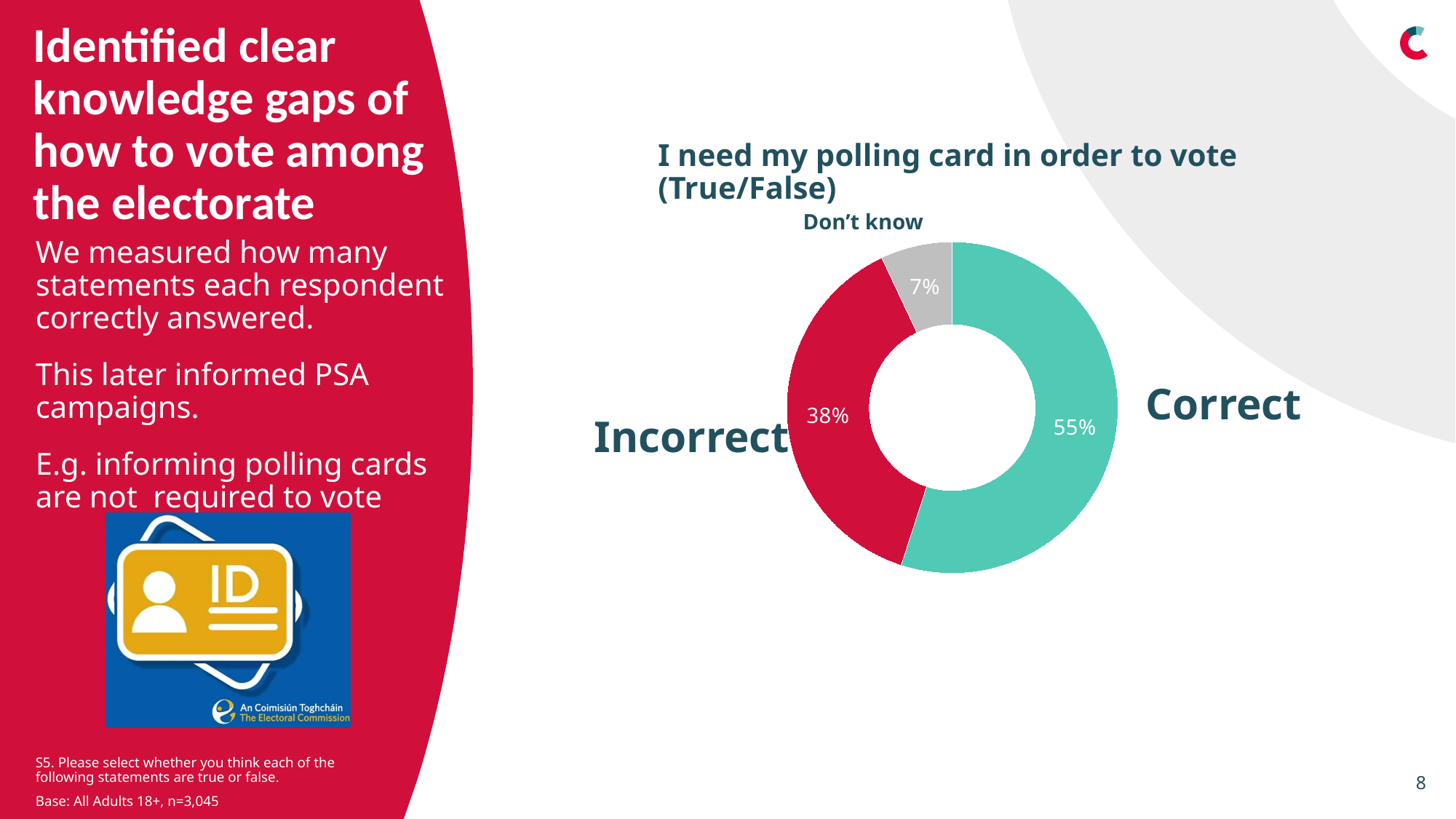
What is the title of the chart? I need my polling card in order to vote (True/False) What kind of chart is shown on the slide? Doughnut chart What percentage of respondents answered Incorrect? 38% What is the difference in percentage points between Correct and Incorrect? 17 What colour is the Incorrect segment of the chart? Red How many categories are shown in the chart? 3 Which category has the largest share of the chart? Correct What percentage of respondents answered Correct? 55% Which is larger, the share for Incorrect or the share for Don't know? Incorrect What is the difference in percentage points between Incorrect and Don't know? 31 Which category has the smallest share of the chart? Don't know What percentage of respondents said Don't know? 7%